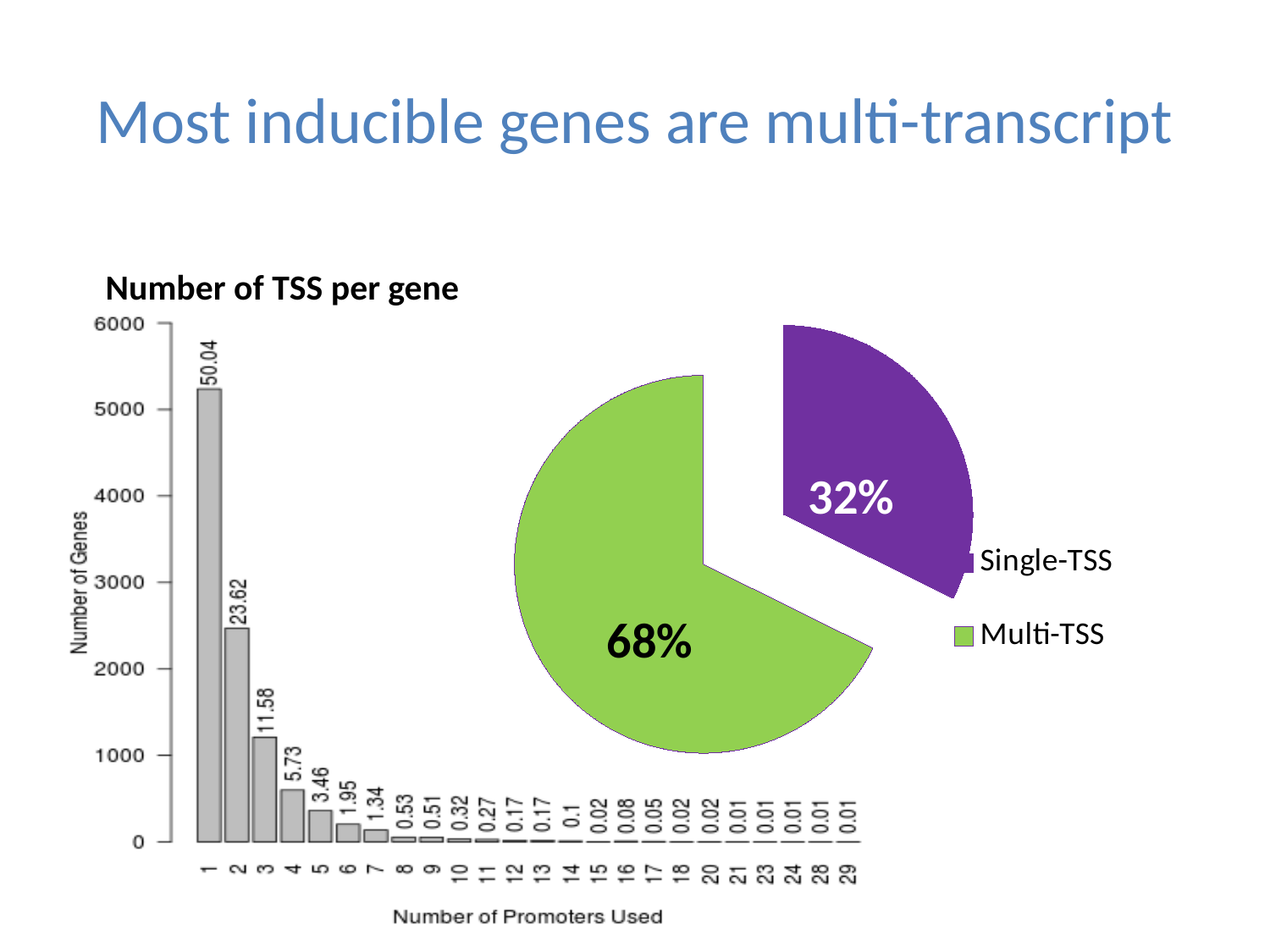
In the bar chart 'Number of TSS per gene', is the bar for 4 promoters used greater or less than 1000 on the Number of Genes axis? less In the bar chart 'Number of TSS per gene', what is the data label on the bar for 6 promoters used? 1.95 In the bar chart 'Number of TSS per gene', what is the data label on the bar for 1 promoter used? 50.04 In the pie chart on the right, what colour is the Single-TSS slice? purple In the bar chart 'Number of TSS per gene', is the bar for 2 promoters used greater or less than 2000 on the Number of Genes axis? greater In the pie chart on the right, which slice is larger, Single-TSS or Multi-TSS? Multi-TSS In the bar chart 'Number of TSS per gene', do the bar heights rise or fall as the number of promoters used increases? fall In the bar chart 'Number of TSS per gene', how many categories are shown on the x axis? 24 In the bar chart 'Number of TSS per gene', what is the data label on the bar for 3 promoters used? 11.58 In the pie chart on the right, what share of genes is Multi-TSS? 68% In the bar chart 'Number of TSS per gene', what is the difference between the data labels for 1 and 2 promoters used? 26.42 In the bar chart 'Number of TSS per gene', which number of promoters used has the tallest bar? 1